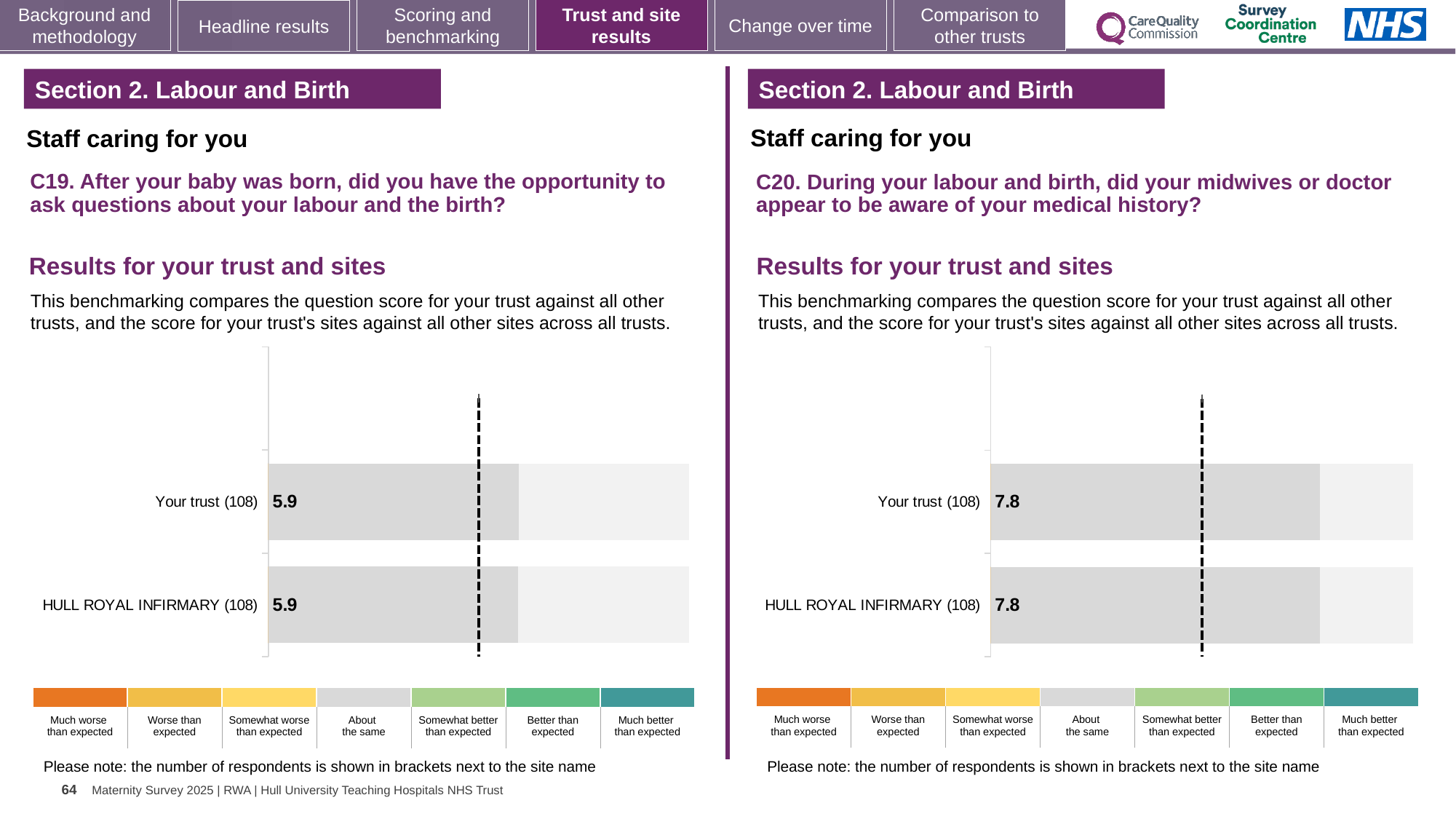
How many categories does the colour key below the right chart (C20) list? 7 On the right chart (C20), what is the difference between the score for Your trust and the score for HULL ROYAL INFIRMARY? 0 On the left chart (C19), what is the score for Your trust (108)? 5.9 On the left chart (C19), how many respondents are shown in brackets next to HULL ROYAL INFIRMARY? 108 On the left chart (C19), what is the score for HULL ROYAL INFIRMARY (108)? 5.9 What kind of chart is used on the right (C20)? Bar chart How many bars are plotted on the left chart (C19)? 2 How many bars are plotted on the right chart (C20)? 2 On the right chart (C20), what is the score for Your trust (108)? 7.8 What kind of chart is used on the left (C19)? Bar chart On the left chart (C19), what is the difference between the score for Your trust and the score for HULL ROYAL INFIRMARY? 0 On the right chart (C20), what is the score for HULL ROYAL INFIRMARY (108)? 7.8